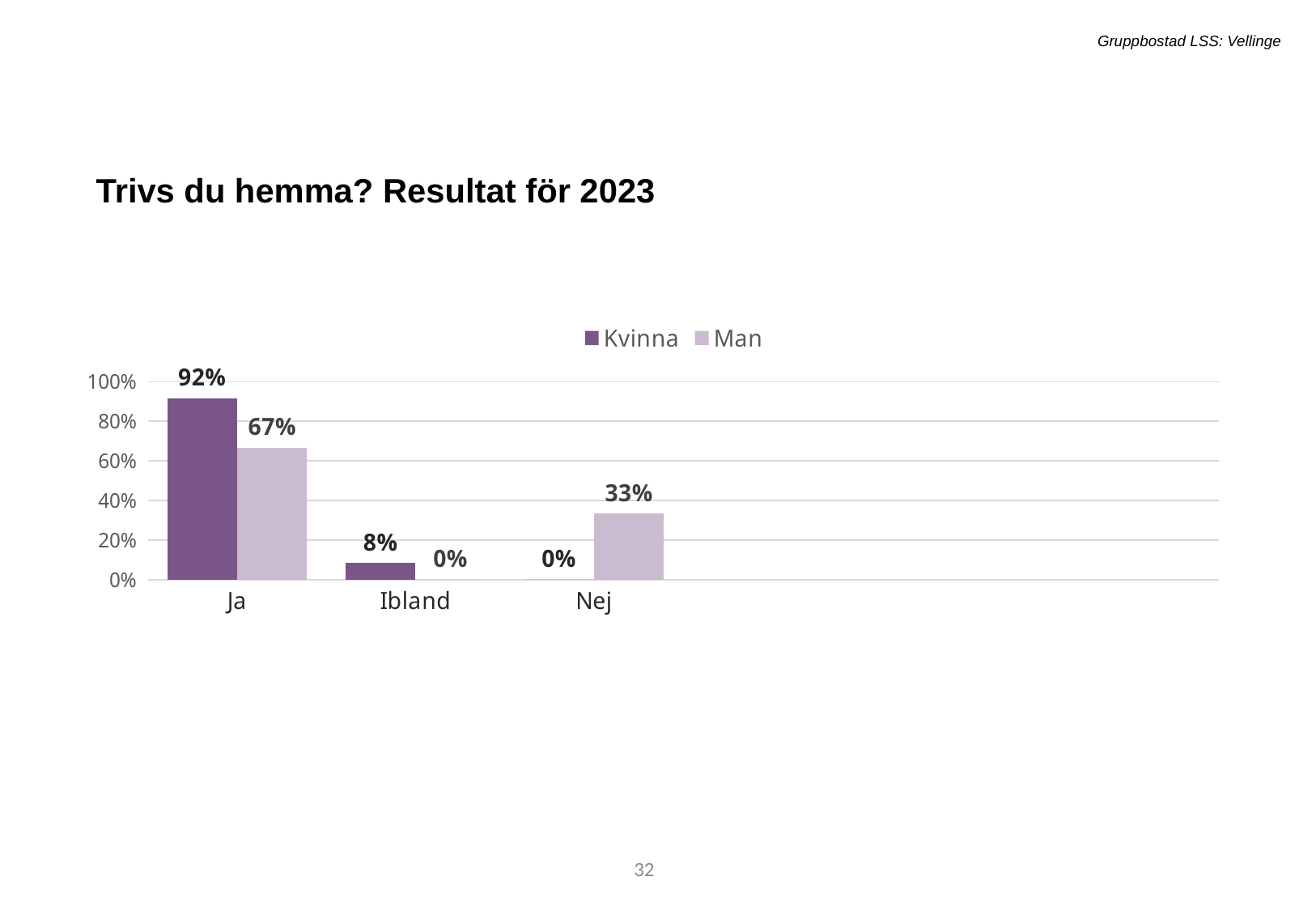
What is the value for Man in the Nej category? 33% Which category has the lowest value for the Kvinna series? Nej What is the difference between the Kvinna and Man values in the Ja category? 25% What is the value for Kvinna in the Ibland category? 8% In the Nej category, which series has the larger value, Kvinna or Man? Man How many series does the legend list? 2 What is the value for Kvinna in the Ja category? 92% What kind of chart is shown on the slide? Bar chart How many categories are shown on the x axis? 3 What are the two series named in the legend? Kvinna and Man What is the value for Man in the Ja category? 67% Which category has the highest value for the Man series? Ja